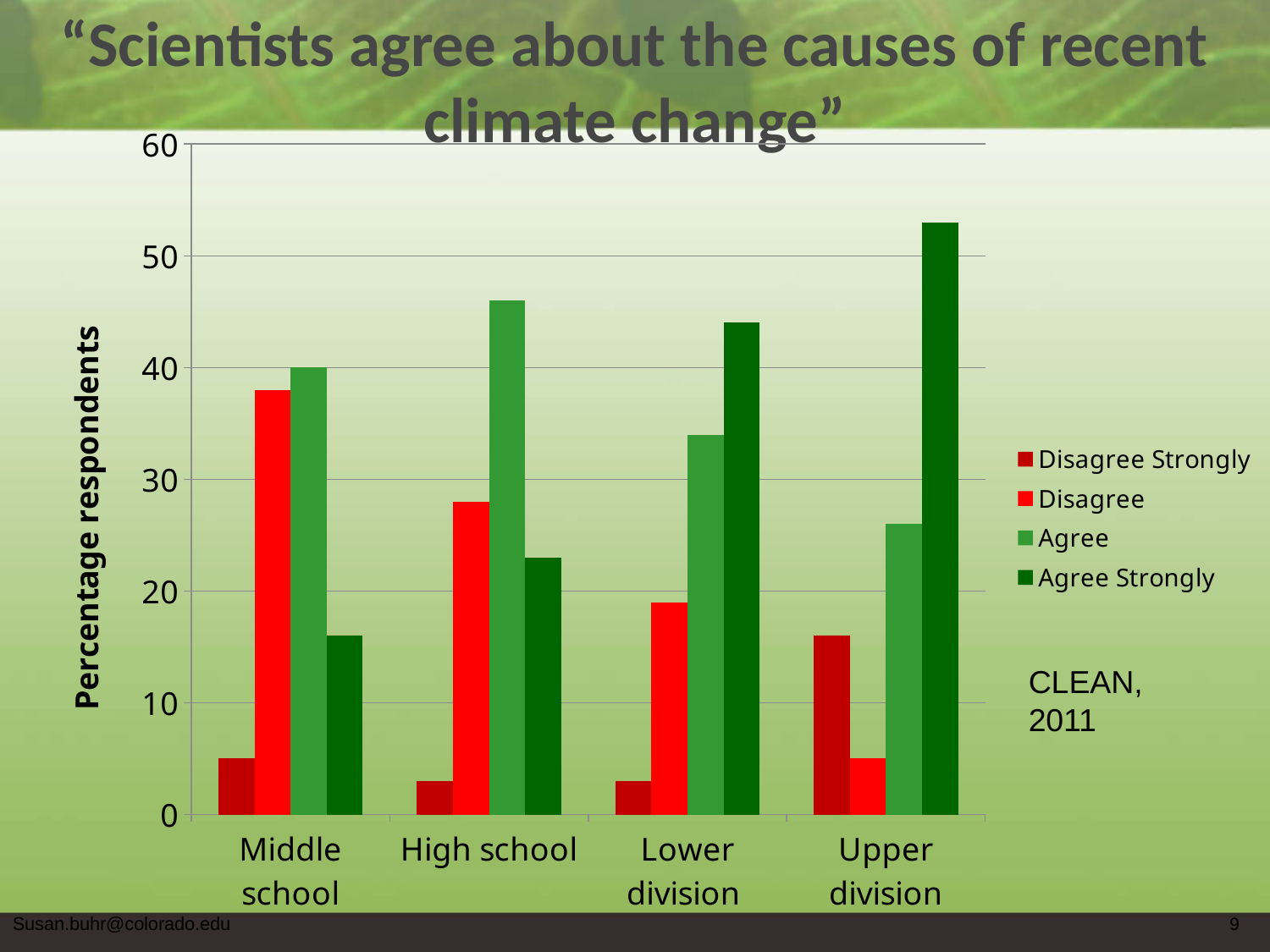
Which category has the highest value for Agree? High school Which category has the lowest value for Agree Strongly? Middle school What kind of chart is shown on the slide? bar chart How many series does the legend list? 4 Which category has the highest value for Agree Strongly? Upper division For Lower division, which is larger: Agree or Agree Strongly? Agree Strongly Is the Agree Strongly value for Upper division greater or less than 50? greater Is the Disagree Strongly value for High school greater or less than 10? less How many categories are shown on the x axis? 4 For Middle school, which is larger: Disagree or Agree Strongly? Disagree Is the Disagree value for Middle school greater or less than 30? greater Do the Agree Strongly values rise or fall from Middle school to Upper division? rise